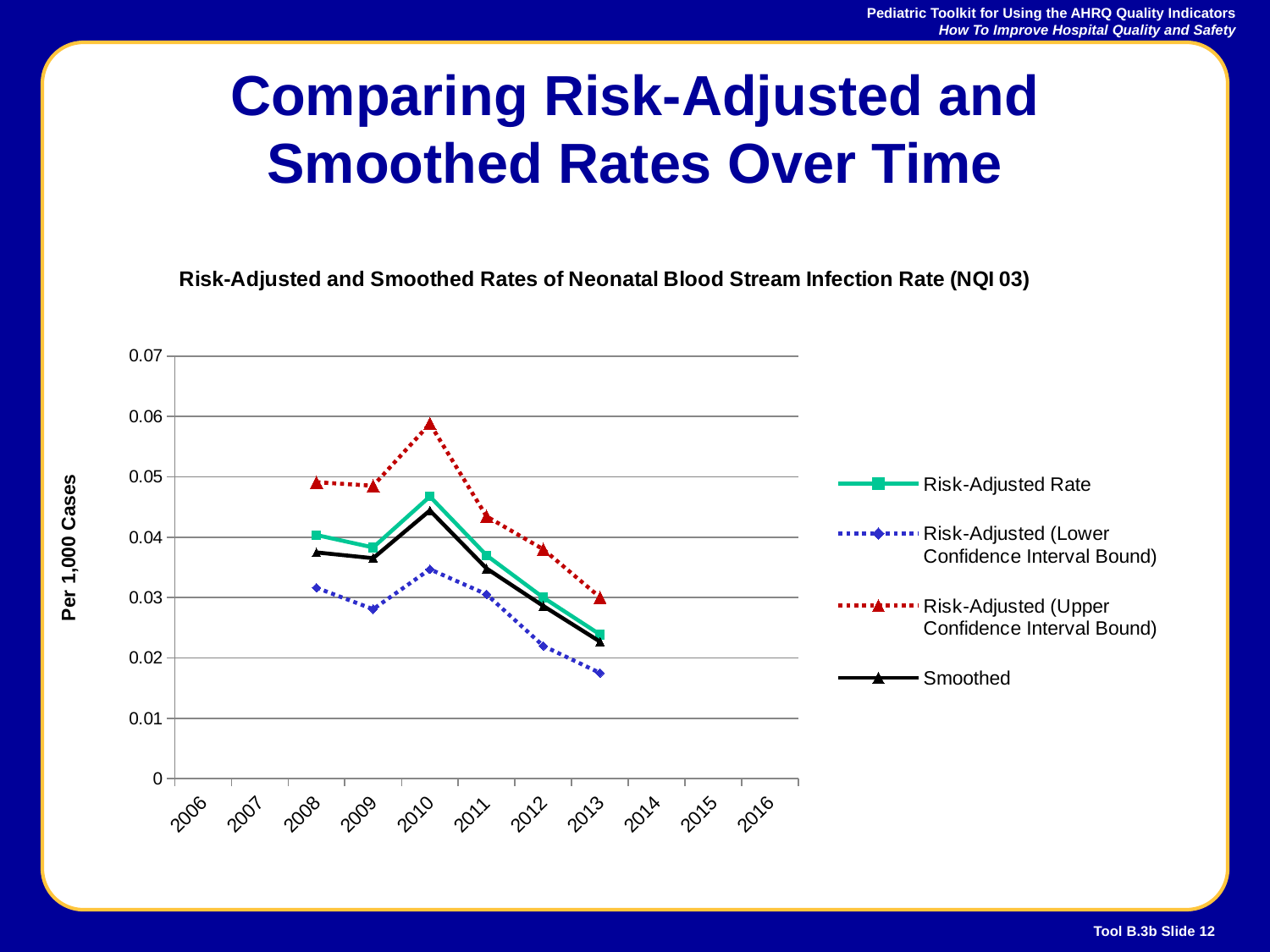
What kind of chart is shown on the slide? Line chart Is the value for the Risk-Adjusted Rate in 2010 greater or less than 0.04? greater How many series does the legend list? 4 In which year does the Risk-Adjusted (Upper Confidence Interval Bound) series reach its highest value? 2010 From 2010 to 2013, does the Risk-Adjusted Rate rise or fall? Fall Is the value for the Smoothed series in 2008 greater or less than 0.04? less For how many years are data points plotted for the Risk-Adjusted Rate series? 6 In 2008, which is higher: the Risk-Adjusted Rate or the Smoothed rate? Risk-Adjusted Rate Is the value for the Risk-Adjusted (Lower Confidence Interval Bound) in 2013 greater or less than 0.02? less In which year does the Risk-Adjusted (Lower Confidence Interval Bound) series reach its lowest value? 2013 What is the label on the vertical axis of the chart? Per 1,000 Cases